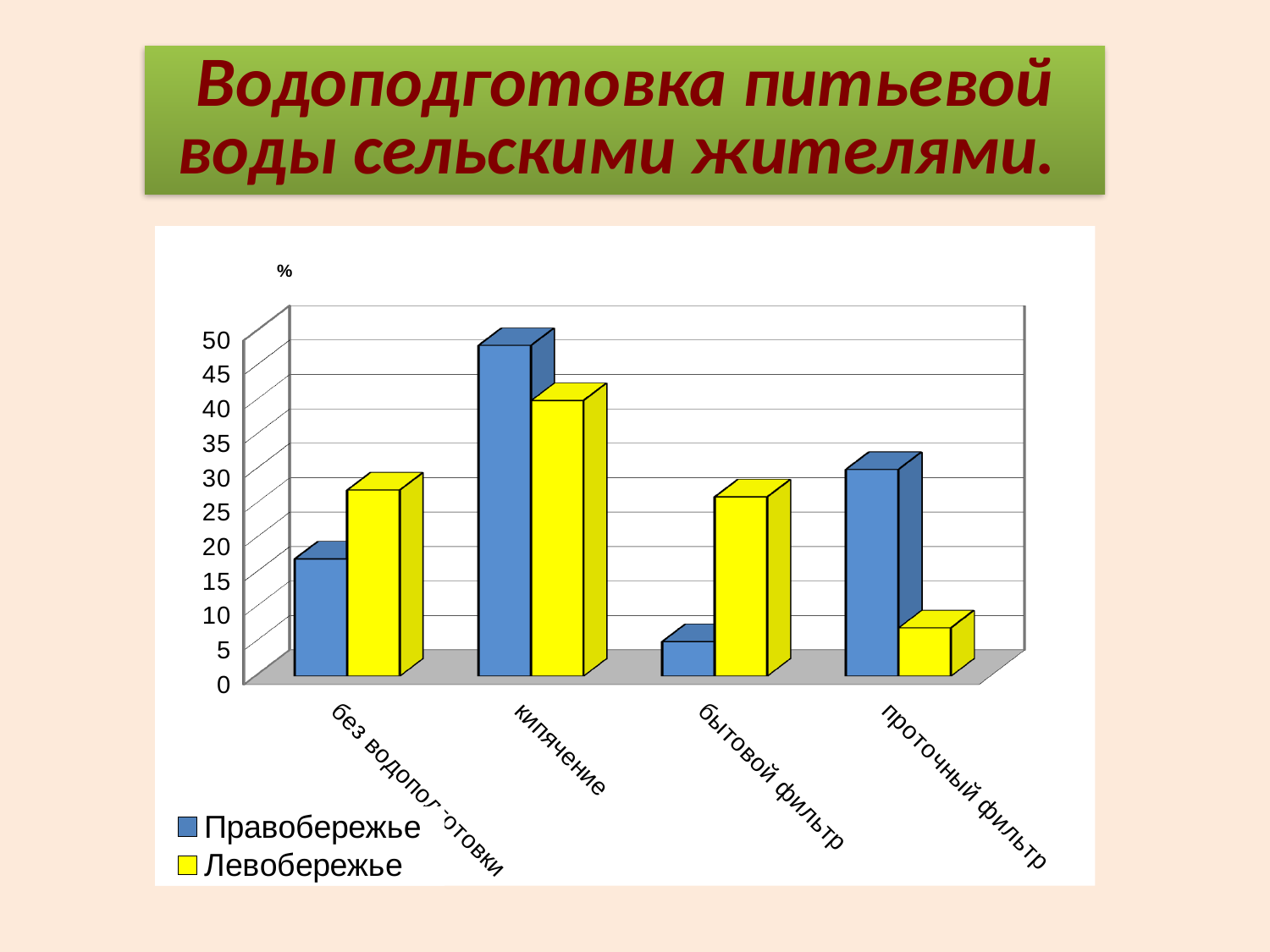
What kind of chart is shown on the slide? bar chart What colour are the bars for Левобережье in the chart? yellow Which category has the lowest value for Левобережье? проточный фильтр For проточный фильтр, which series has the larger value, Правобережье or Левобережье? Правобережье Is the value for Правобережье in бытовой фильтр greater or less than 10? less For бытовой фильтр, which series has the larger value, Правобережье or Левобережье? Левобережье Which category has the lowest value for Правобережье? бытовой фильтр Is the value for Правобережье in кипячение greater or less than 40? greater How many series does the chart legend list? 2 Which category has the highest value for Правобережье? кипячение How many categories are shown along the x axis of the chart? 4 Is the value for Левобережье in проточный фильтр greater or less than 15? less